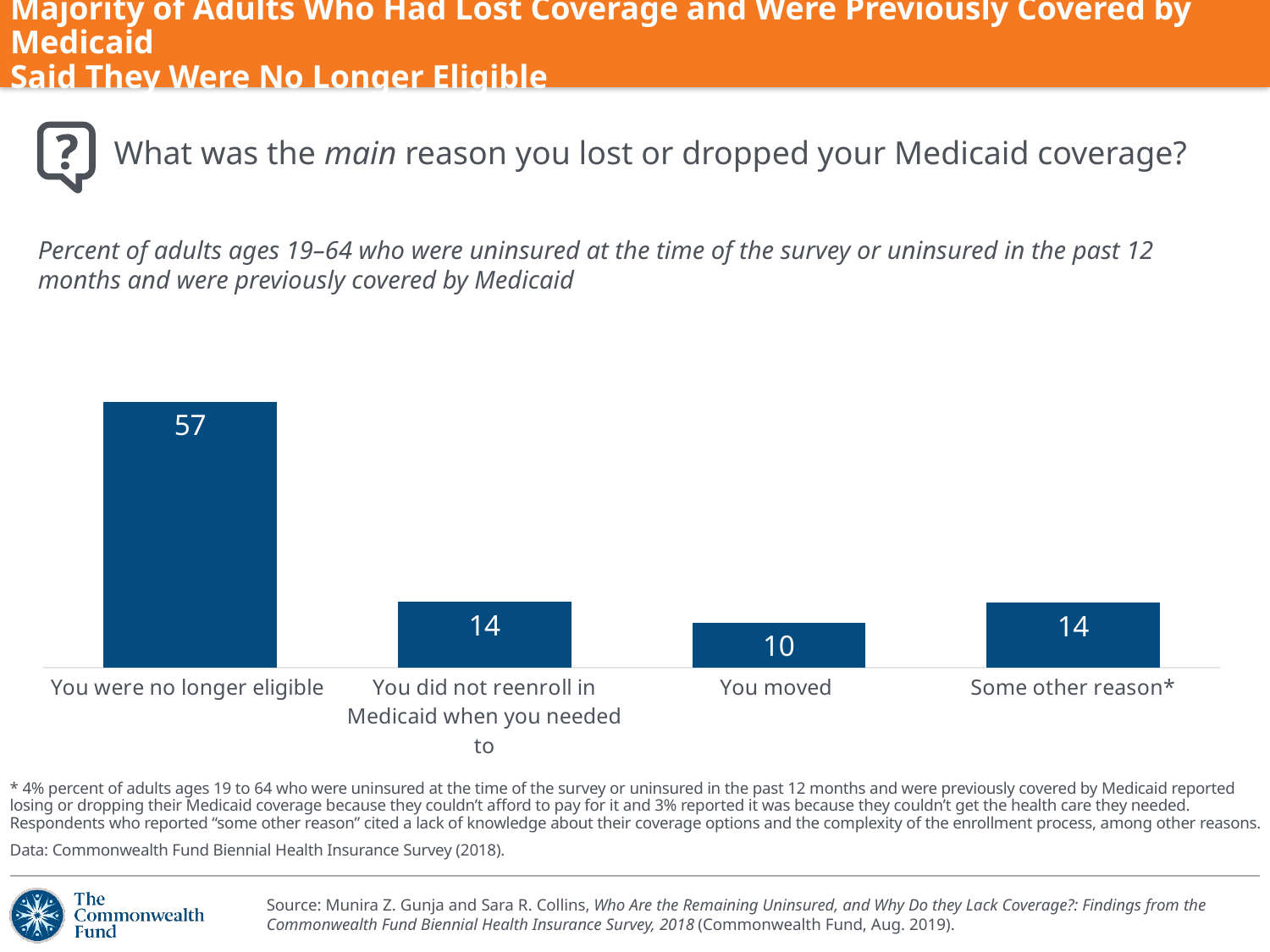
What is the value for "You moved"? 10 Which is larger, the value for "You did not reenroll in Medicaid when you needed to" or the value for "You moved"? You did not reenroll in Medicaid when you needed to How many categories are shown in the chart? 4 What kind of chart is shown on the slide? Bar chart Which category has the lowest value? You moved What is the value for "You did not reenroll in Medicaid when you needed to"? 14 What is the difference between the values for "You were no longer eligible" and "You moved"? 47 What is the value for "Some other reason*"? 14 What is the difference between the values for "You were no longer eligible" and "Some other reason*"? 43 What is the value for "You were no longer eligible"? 57 Which category has the highest value? You were no longer eligible What question does the chart's data answer, as stated on the slide? What was the main reason you lost or dropped your Medicaid coverage?